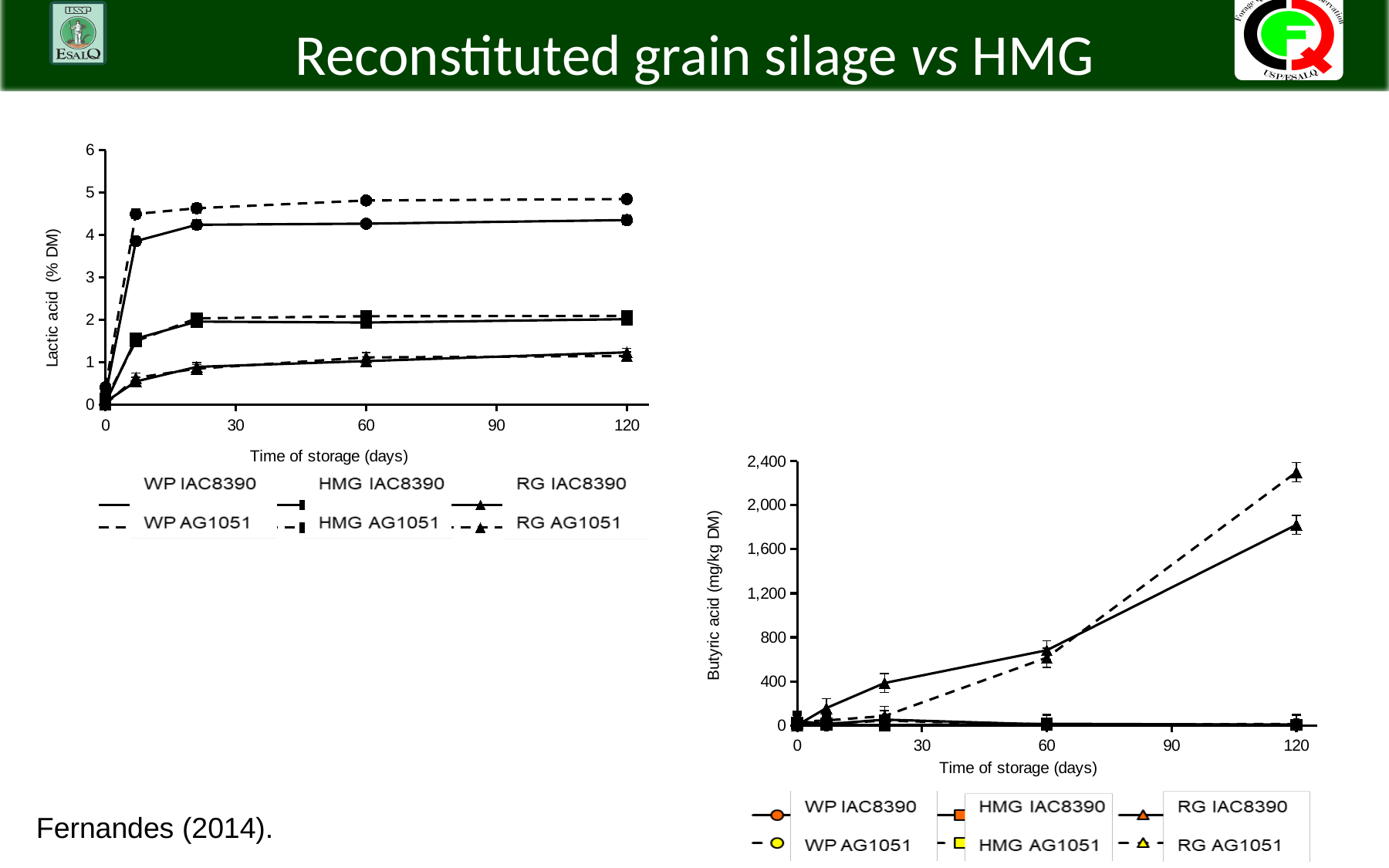
In the butyric acid chart on the right, is the value for RG AG1051 at 120 days greater or less than 2,000? greater In the butyric acid chart on the right, which series reaches the highest value at 120 days? RG AG1051 In the lactic acid chart on the left, is the value for WP IAC8390 at 120 days greater or less than 4? greater What type of chart is the lactic acid chart on the left of the slide? Line chart In the lactic acid chart on the left, what is the label of the y axis? Lactic acid (% DM) In the butyric acid chart on the right, is the value for RG IAC8390 at 120 days greater or less than 2,000? less In the butyric acid chart on the right, at 120 days, which is larger: RG AG1051 or RG IAC8390? RG AG1051 How many series does the legend of the butyric acid chart on the right list? 6 In the butyric acid chart on the right, what is the label of the x axis? Time of storage (days) In the lactic acid chart on the left, which series has the highest value at 120 days? WP AG1051 In the butyric acid chart on the right, do the values for RG AG1051 rise or fall as time of storage increases? rise